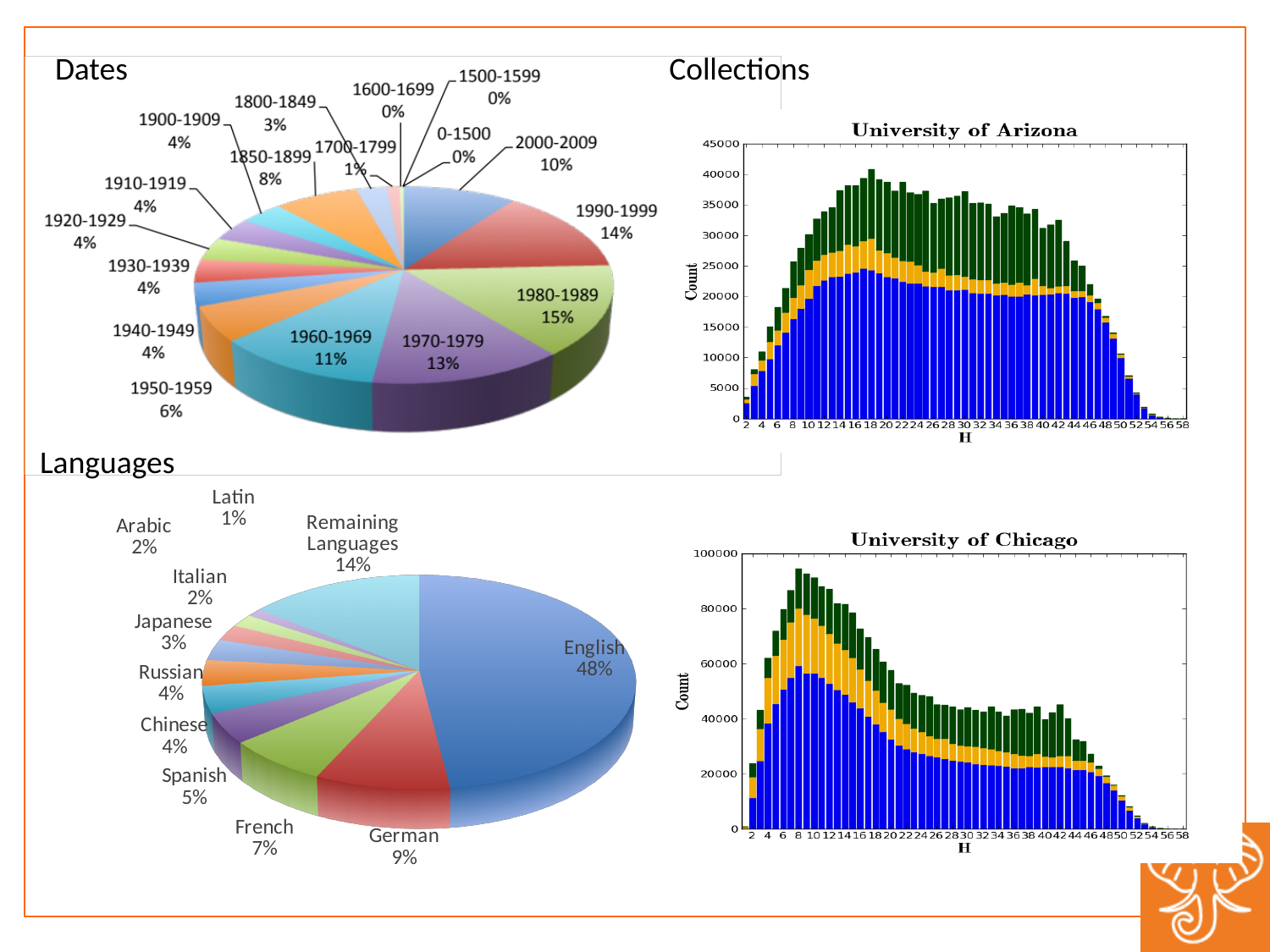
In the Languages pie chart, what is the difference in percentage points between German and French? 2 In the University of Chicago chart, is the total count at H=8 greater or less than 80000? greater In the Languages pie chart, what share of the pie is English? 48% In the Dates pie chart, which date range has the largest share? 1980-1989 In the Dates pie chart, what is the difference in percentage points between 1990-1999 and 1950-1959? 8 What kind of chart is the University of Arizona chart? bar chart In the University of Arizona chart, is the total count at H=18 greater or less than 35000? greater In the Dates pie chart, which is larger, the share for 1960-1969 or the share for 2000-2009? 1960-1969 In the Dates pie chart, what share of the pie is 1980-1989? 15% How many slices does the Languages pie chart have? 11 In the Languages pie chart, which named language has the smallest share? Latin In the Dates pie chart, what share is shown for 1850-1899? 8%